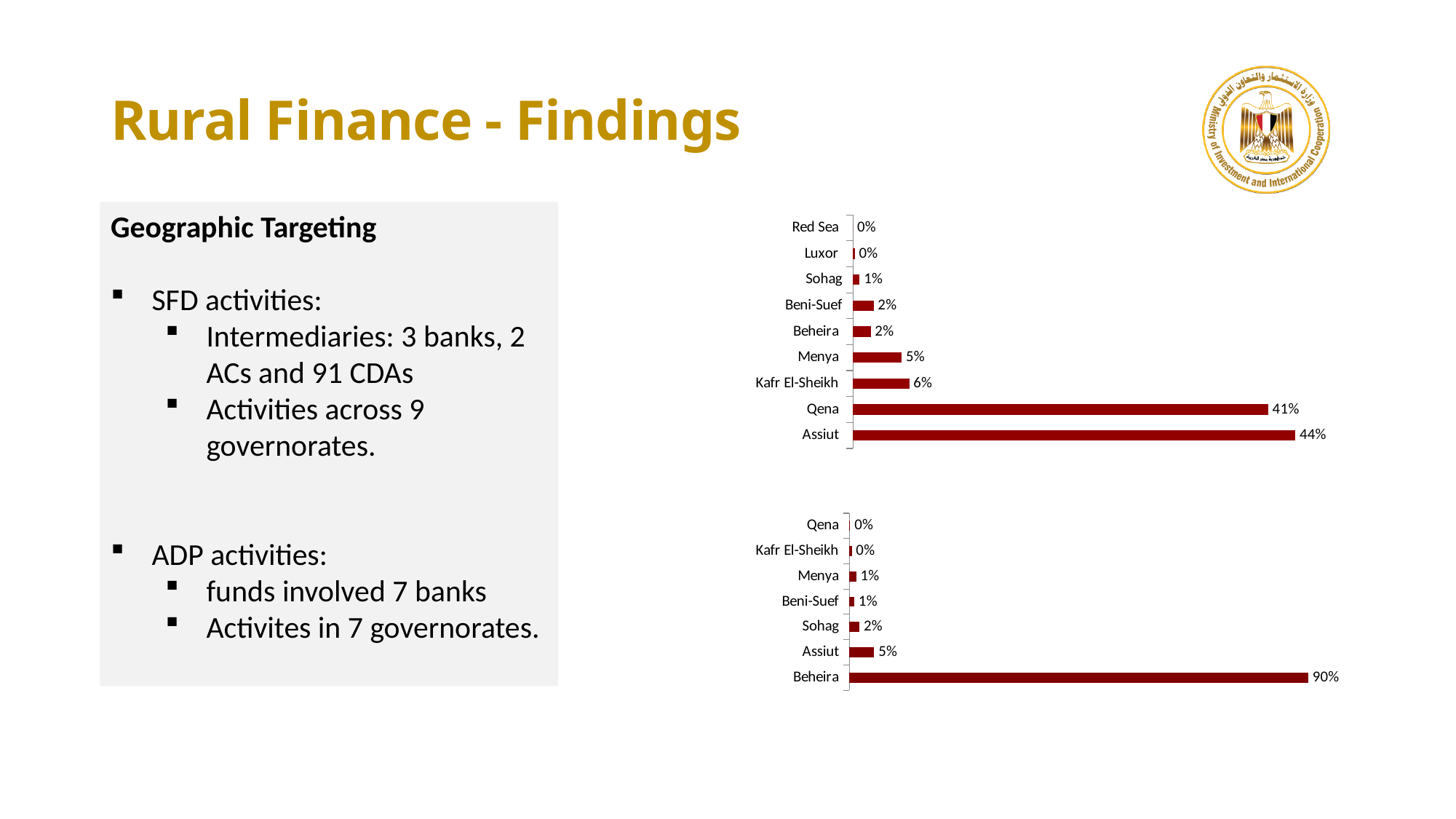
In the bottom chart, which governorate has the highest value? Beheira In the top chart, what is the difference between the values for Assiut and Qena? 3% In the bottom chart, which is larger, the value for Sohag or the value for Assiut? Assiut In the bottom chart, how many governorates are listed? 7 In the top chart, what is the value for Kafr El-Sheikh? 6% In the top chart, how many governorates are listed? 9 In the top chart, what is the value for Qena? 41% In the top chart, what is the value for Assiut? 44% In the bottom chart, what is the value for Assiut? 5% In the bottom chart, what is the value for Beheira? 90% What type of chart is the top chart? Bar chart In the top chart, which governorate has the highest value? Assiut